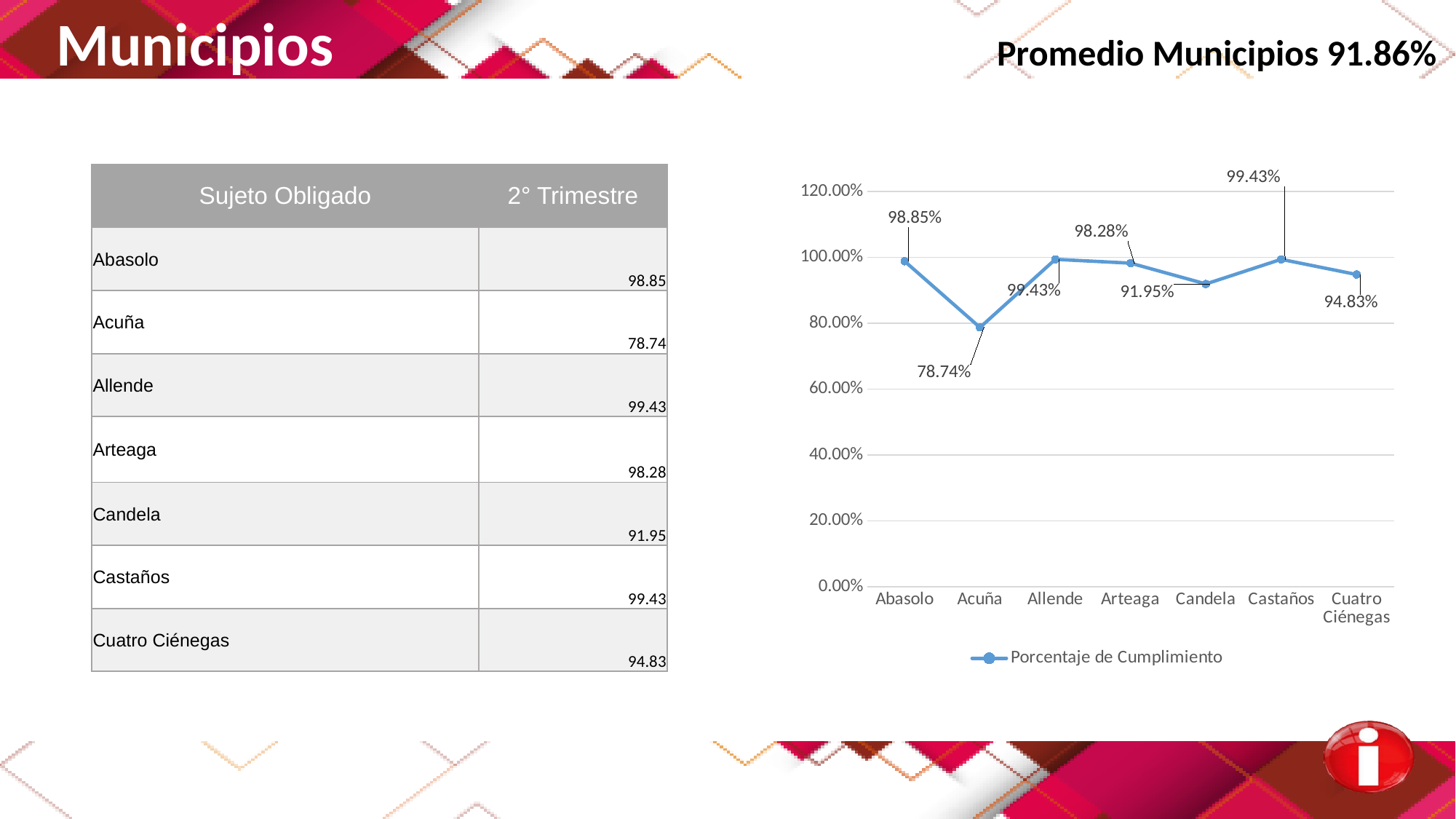
What kind of chart is shown on the slide? line chart What series name does the chart legend show? Porcentaje de Cumplimiento What is the value for Arteaga in the chart? 98.28% How many categories are plotted on the x axis of the chart? 7 Which category has the lowest value in the chart? Acuña What is the difference between the values for Abasolo and Acuña? 20.11% What is the value for Cuatro Ciénegas in the chart? 94.83% What is the value for Candela in the chart? 91.95% Which is larger, the value for Candela or the value for Cuatro Ciénegas? Cuatro Ciénegas Is the value for Acuña greater or less than 80.00%? less What is the value for Acuña in the chart? 78.74% What is the difference between the values for Castaños and Cuatro Ciénegas? 4.60%